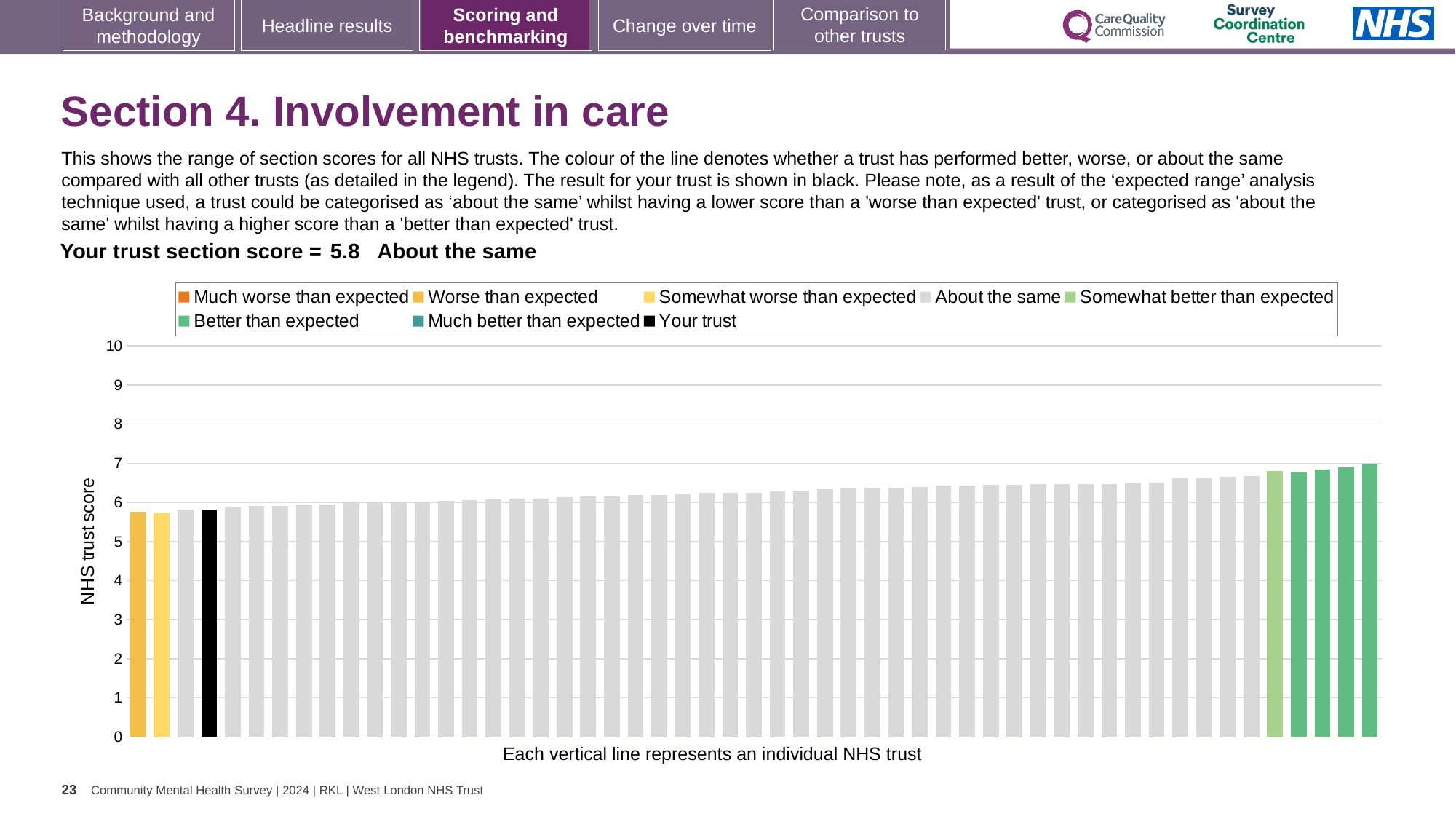
Which is larger, the leftmost bar or the rightmost bar? the rightmost bar Which performance category is your trust placed in according to the slide? About the same What is the label on the vertical axis of the chart? NHS trust score How many entries does the chart legend list? 8 Is the value of the black 'Your trust' bar greater or less than 5? greater What is the section score for your trust shown on the slide? 5.8 Do the bar values rise or fall from left to right along the x axis? rise Is the value of the black 'Your trust' bar greater or less than 6? less Is the value of the leftmost bar greater or less than 5? greater How many bars are coloured yellow (worse or somewhat worse than expected)? 2 What kind of chart is shown on the slide? bar chart